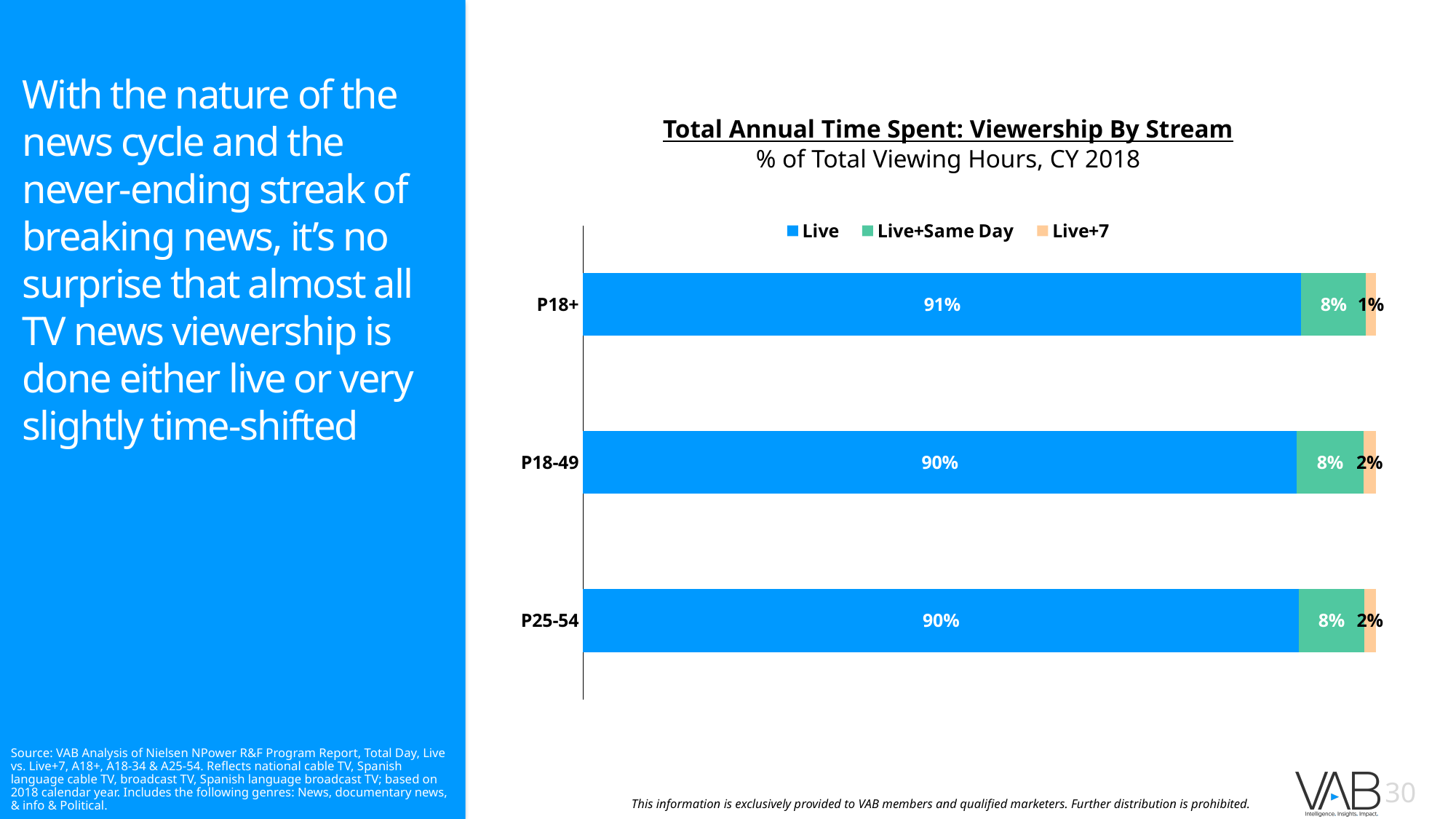
How many demographic groups are shown in the chart? 3 Which demographic has the lowest Live+7 share? P18+ What is the Live+7 value for P18+? 1% What kind of chart is shown? Stacked bar chart Is the Live value for P25-54 larger or smaller than the Live value for P18+? smaller How many series does the legend list? 3 Which demographic has the highest Live share? P18+ What is the title of the chart? Total Annual Time Spent: Viewership By Stream What is the Live+7 value for P25-54? 2% What is the difference between the Live value for P18+ and the Live value for P18-49? 1% What is the Live value for P18+? 91% What is the Live+Same Day value for P18-49? 8%